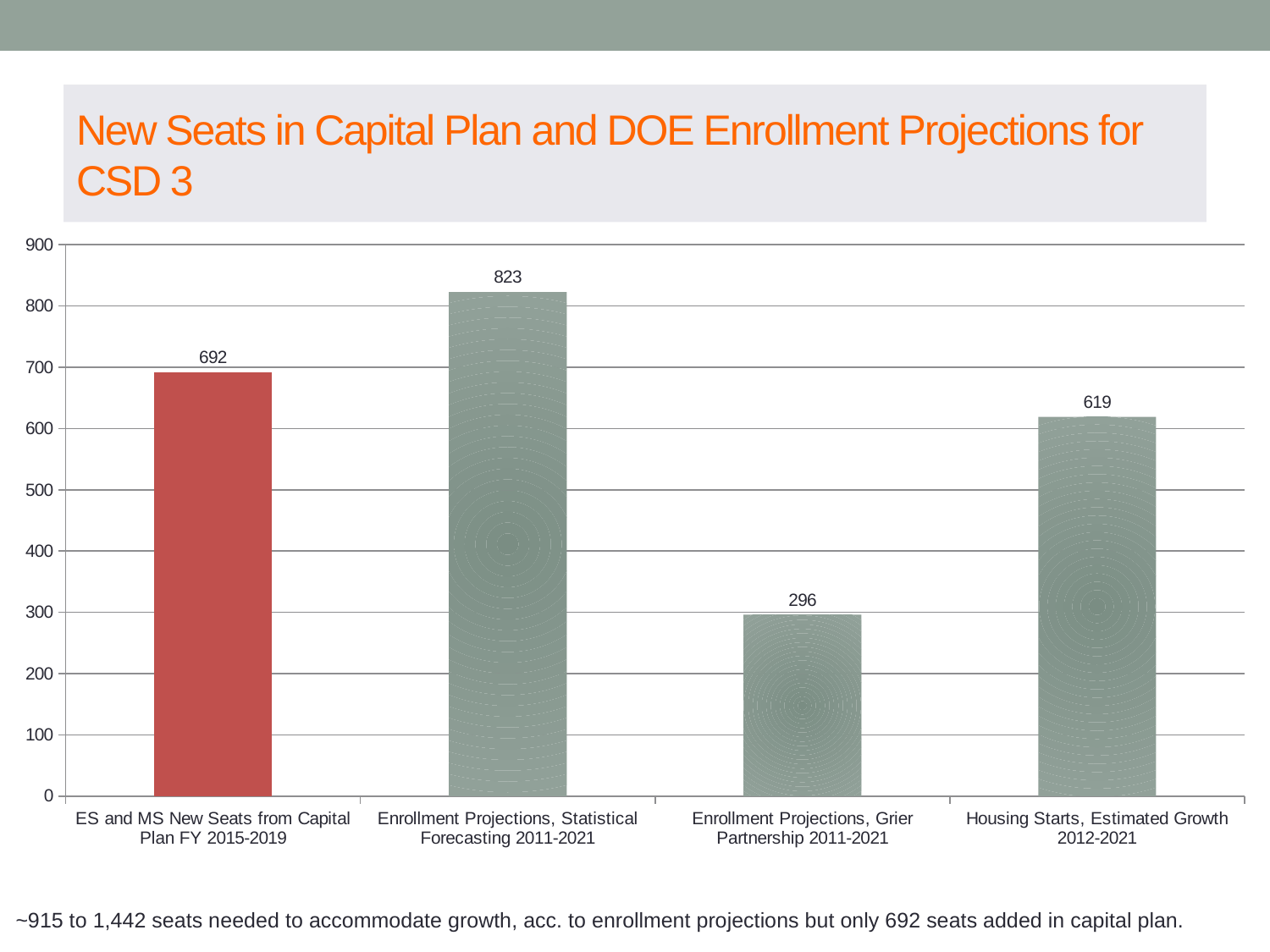
How many categories are shown on the chart? 4 Which bar is coloured red rather than grey-green? ES and MS New Seats from Capital Plan FY 2015-2019 What is the value for Housing Starts, Estimated Growth 2012-2021? 619 What is the value for Enrollment Projections, Grier Partnership 2011-2021? 296 What is the difference between the Housing Starts, Estimated Growth 2012-2021 value and the Enrollment Projections, Grier Partnership 2011-2021 value? 323 Which is larger: the value for ES and MS New Seats from Capital Plan FY 2015-2019 or the value for Housing Starts, Estimated Growth 2012-2021? ES and MS New Seats from Capital Plan FY 2015-2019 Which category has the highest value? Enrollment Projections, Statistical Forecasting 2011-2021 What kind of chart is shown on the slide? Bar chart What is the difference between the Statistical Forecasting enrollment projection and the new seats from the capital plan? 131 Which category has the lowest value? Enrollment Projections, Grier Partnership 2011-2021 What is the value for ES and MS New Seats from Capital Plan FY 2015-2019? 692 What is the value for Enrollment Projections, Statistical Forecasting 2011-2021? 823